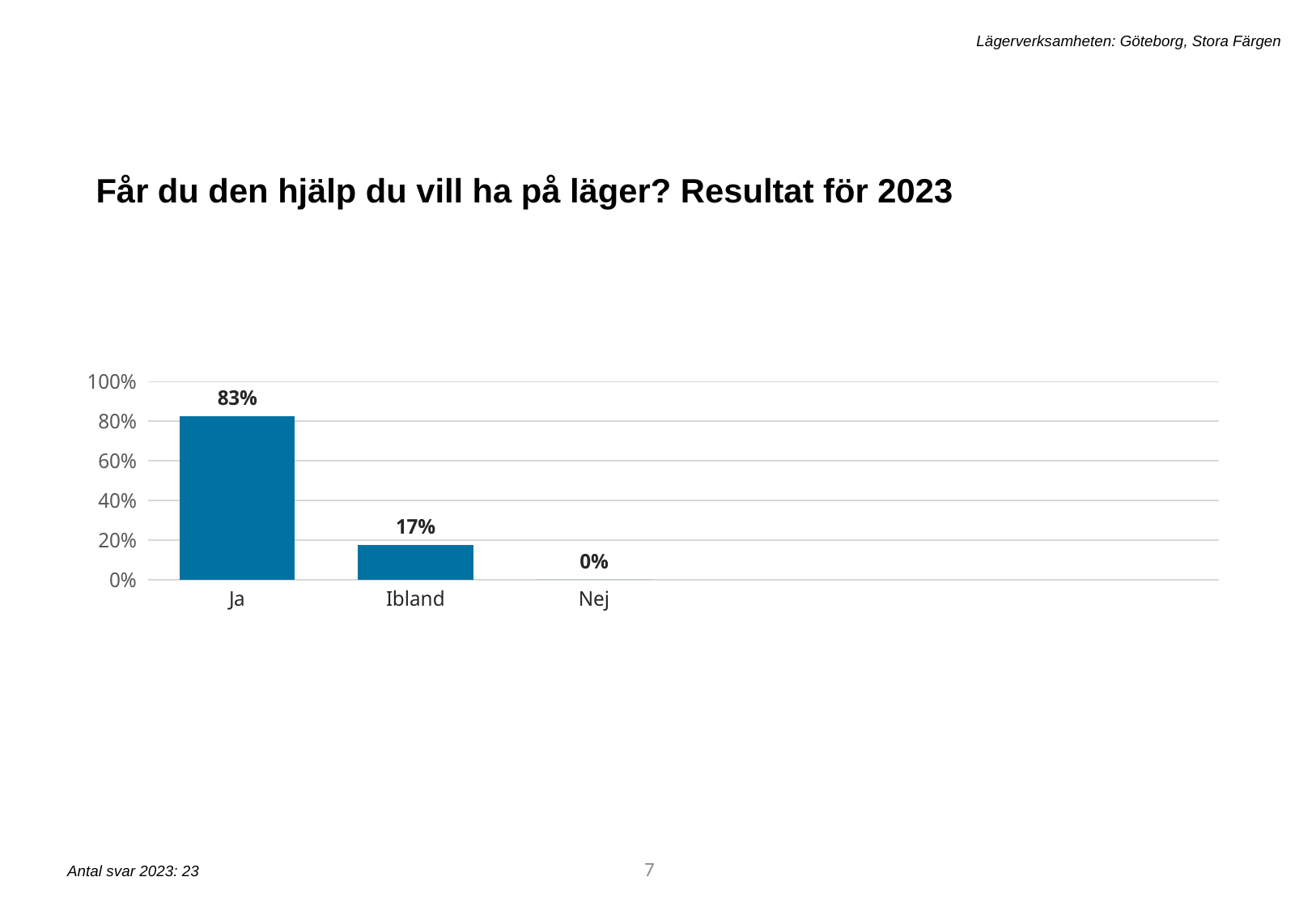
Is the value for Ja greater or less than 60%? greater How many categories are shown on the x axis? 3 Which category has the highest value? Ja What is the value for Ja? 83% What kind of chart is shown on the slide? bar chart Do the values rise or fall from left to right along the x axis? fall What is the difference between the values for Ja and Ibland? 66% Which category has the lowest value? Nej Is the value for Ibland greater or less than 20%? less What is the value for Nej? 0% Which is larger, the value for Ibland or the value for Nej? Ibland What is the value for Ibland? 17%